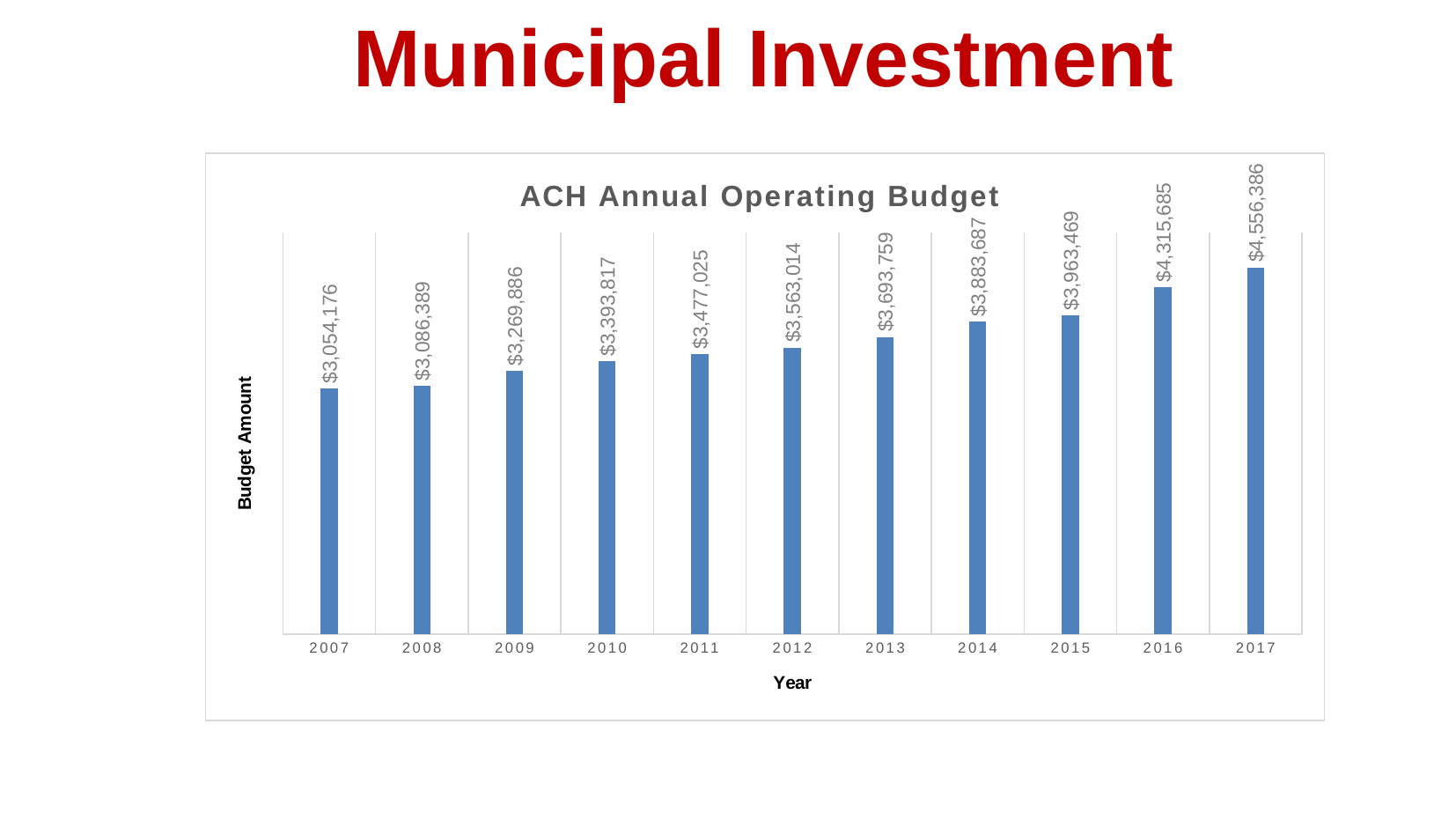
How much larger is the 2017 budget than the 2007 budget? $1,502,210 What is the ACH annual operating budget for 2007? $3,054,176 What is the ACH annual operating budget for 2016? $4,315,685 Does the ACH annual operating budget rise or fall from 2007 to 2017? Rise Which year has a larger budget, 2014 or 2011? 2014 What is the ACH annual operating budget for 2012? $3,563,014 What is the difference between the 2016 and 2015 budgets? $352,216 Which year has the highest ACH annual operating budget? 2017 How many years are shown on the chart? 11 What is the label on the vertical axis of the chart? Budget Amount What type of chart is used to show the ACH Annual Operating Budget? Bar chart Which year has the lowest ACH annual operating budget? 2007